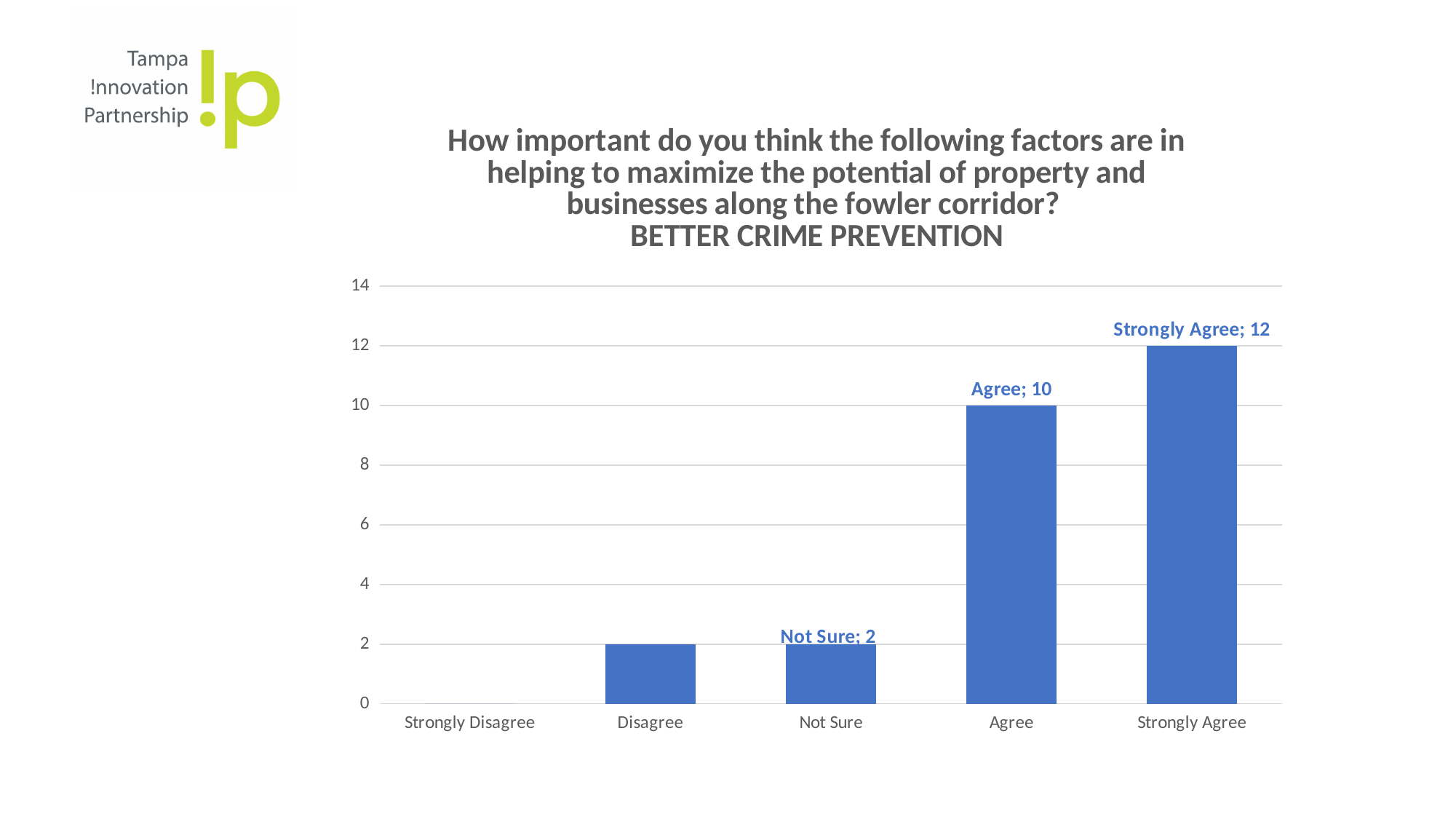
Which category has the lowest value? Strongly Disagree Which category has the highest value? Strongly Agree What is the value for Not Sure? 2 Which is larger, the value for Agree or the value for Not Sure? Agree What is the difference between the values for Strongly Agree and Agree? 2 Is the value for Disagree greater or less than 4? less What is the value for Agree? 10 Which factor does the chart title say the question is about? BETTER CRIME PREVENTION What is the value for Strongly Agree? 12 How many categories are shown on the x axis? 5 What kind of chart is shown on the slide? bar chart Do the values generally rise or fall from left to right along the x axis? rise